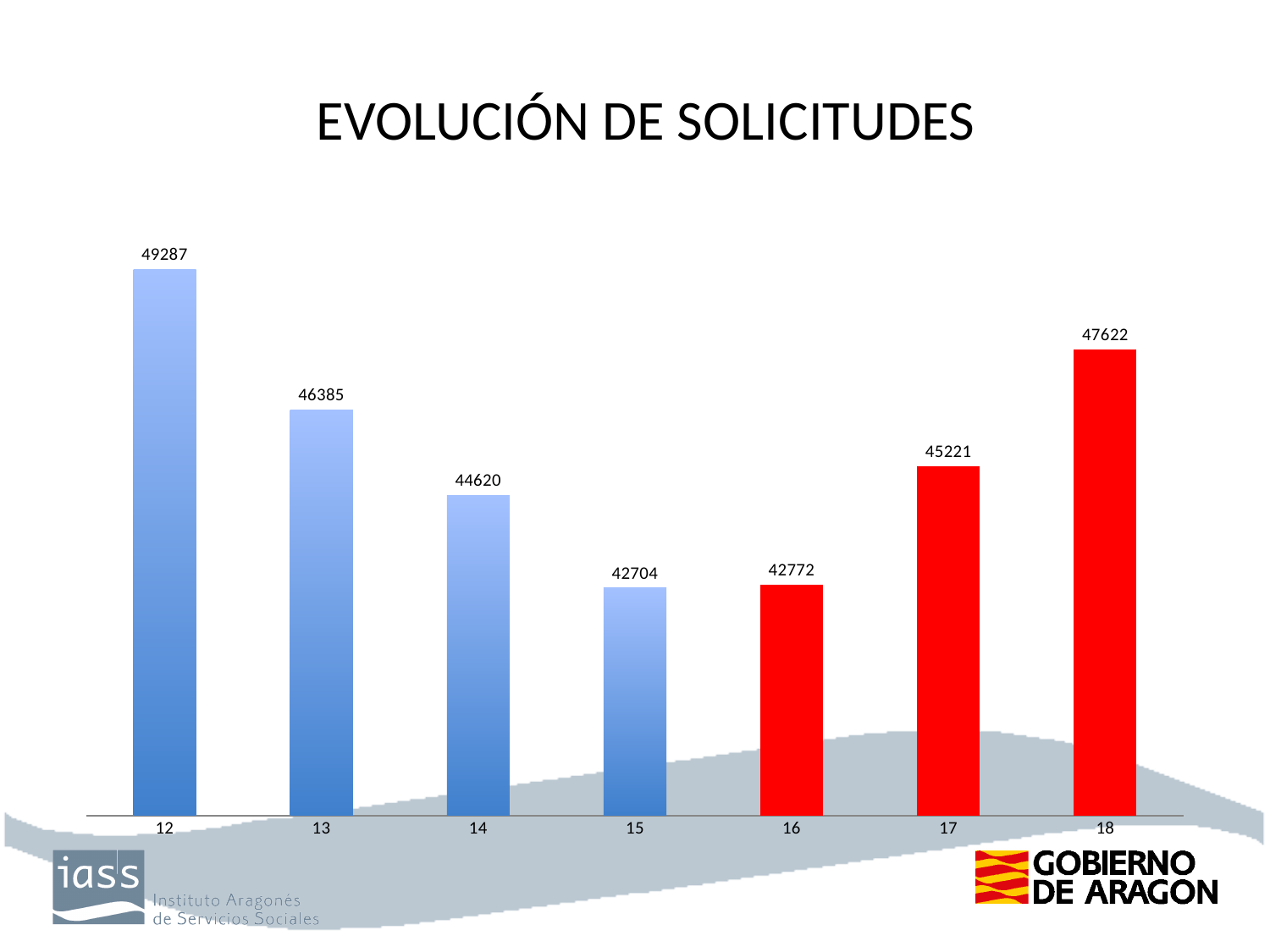
Which category has the lowest value? 15 How many categories are shown on the x axis? 7 Which category has the highest value? 12 Which is larger, the value for 13 or the value for 17? 13 What is the value for category 18? 47622 What kind of chart is this? bar chart What is the difference between the values for 17 and 16? 2449 What is the value for category 16? 42772 What is the value for category 12? 49287 What is the title of the chart? EVOLUCIÓN DE SOLICITUDES What is the difference between the values for 12 and 18? 1665 Do the values rise or fall from category 12 to category 15? fall